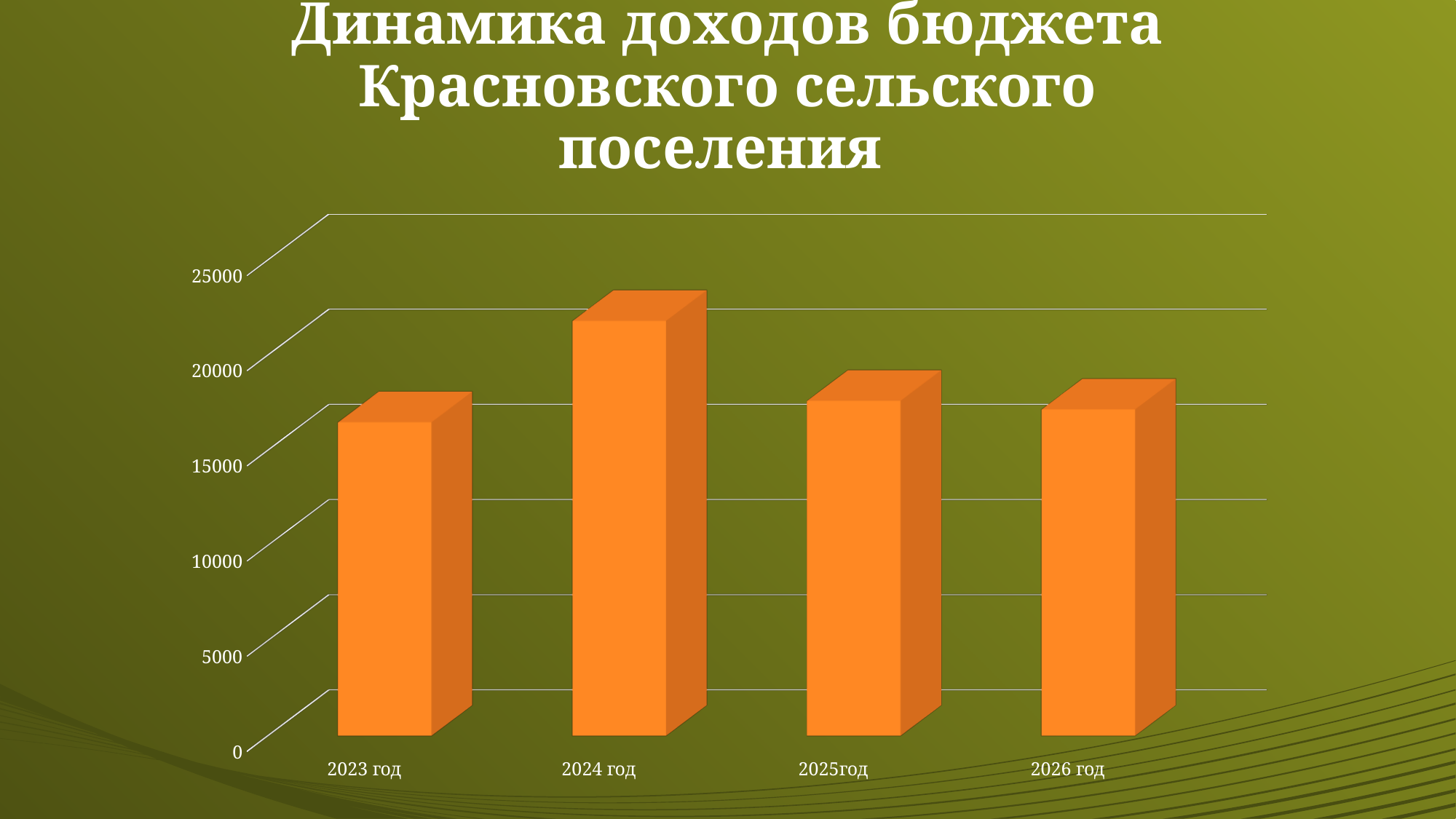
Is the value for 2026 год greater or less than 10000? greater Is the value for 2024 год greater or less than 20000? greater Which year has the highest budget income in the chart? 2024 год What is the title of the chart on the slide? Динамика доходов бюджета Красновского сельского поселения Is the value for 2024 год greater or less than 25000? less How many years (categories) are plotted in the chart? 4 What kind of chart is shown on the slide? bar chart Which is larger, the value for 2024 год or the value for 2025год? 2024 год Which is larger, the value for 2024 год or the value for 2023 год? 2024 год Does the value rise or fall from 2024 год to 2025год? fall